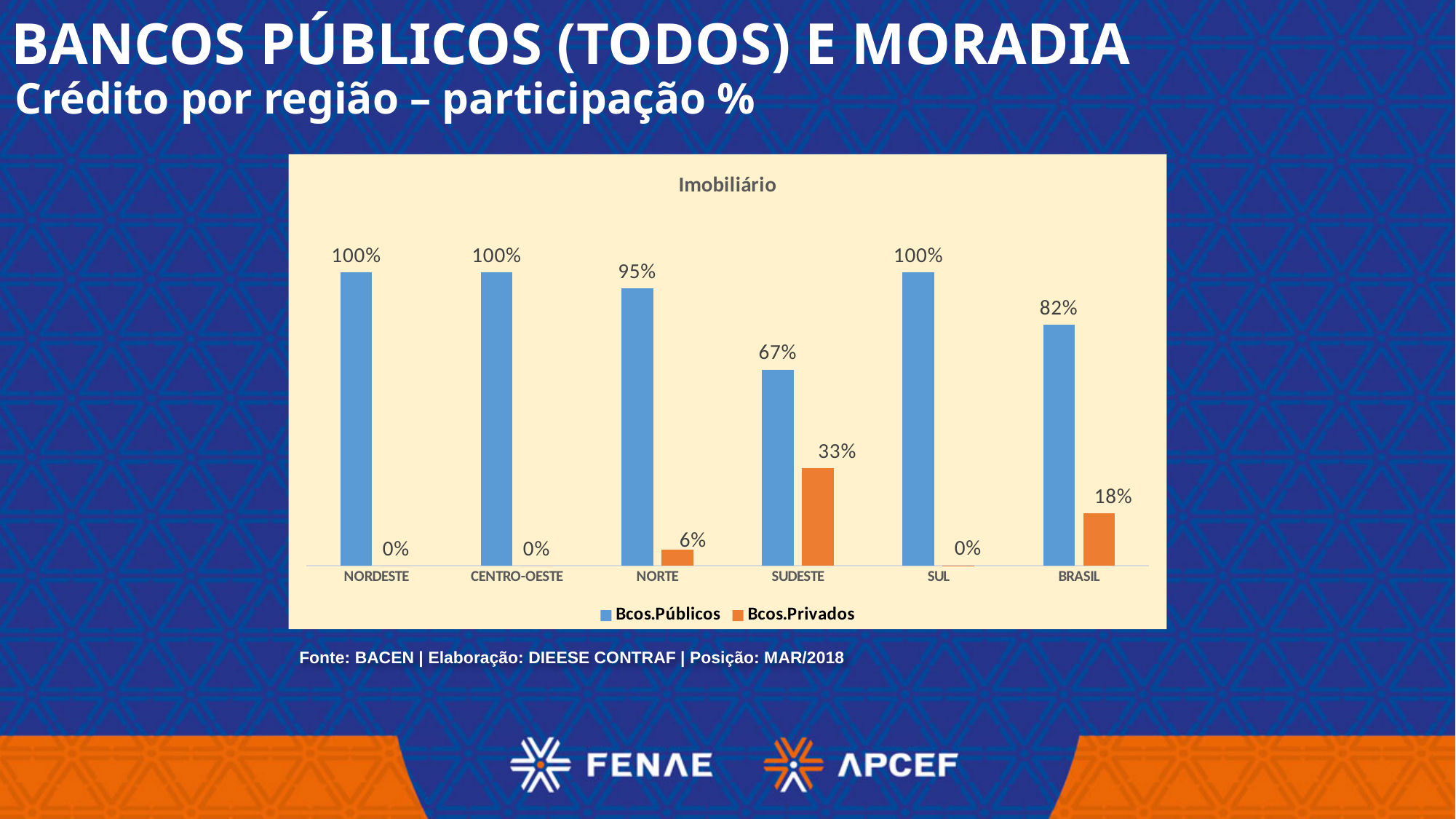
What is the difference between the Bcos.Públicos and Bcos.Privados values for BRASIL? 64% How many regions are shown on the x axis? 6 Which is larger, the Bcos.Públicos value for NORTE or for BRASIL? NORTE What is the Bcos.Privados value for SUDESTE? 33% What is the Bcos.Privados value for BRASIL? 18% Which region has the lowest Bcos.Públicos value? SUDESTE What is the Bcos.Públicos value for NORTE? 95% What kind of chart is shown? Bar chart What is the Bcos.Públicos value for SUDESTE? 67% Which region has the highest Bcos.Privados value? SUDESTE How many series does the legend list? 2 What is the title of the chart? Imobiliário